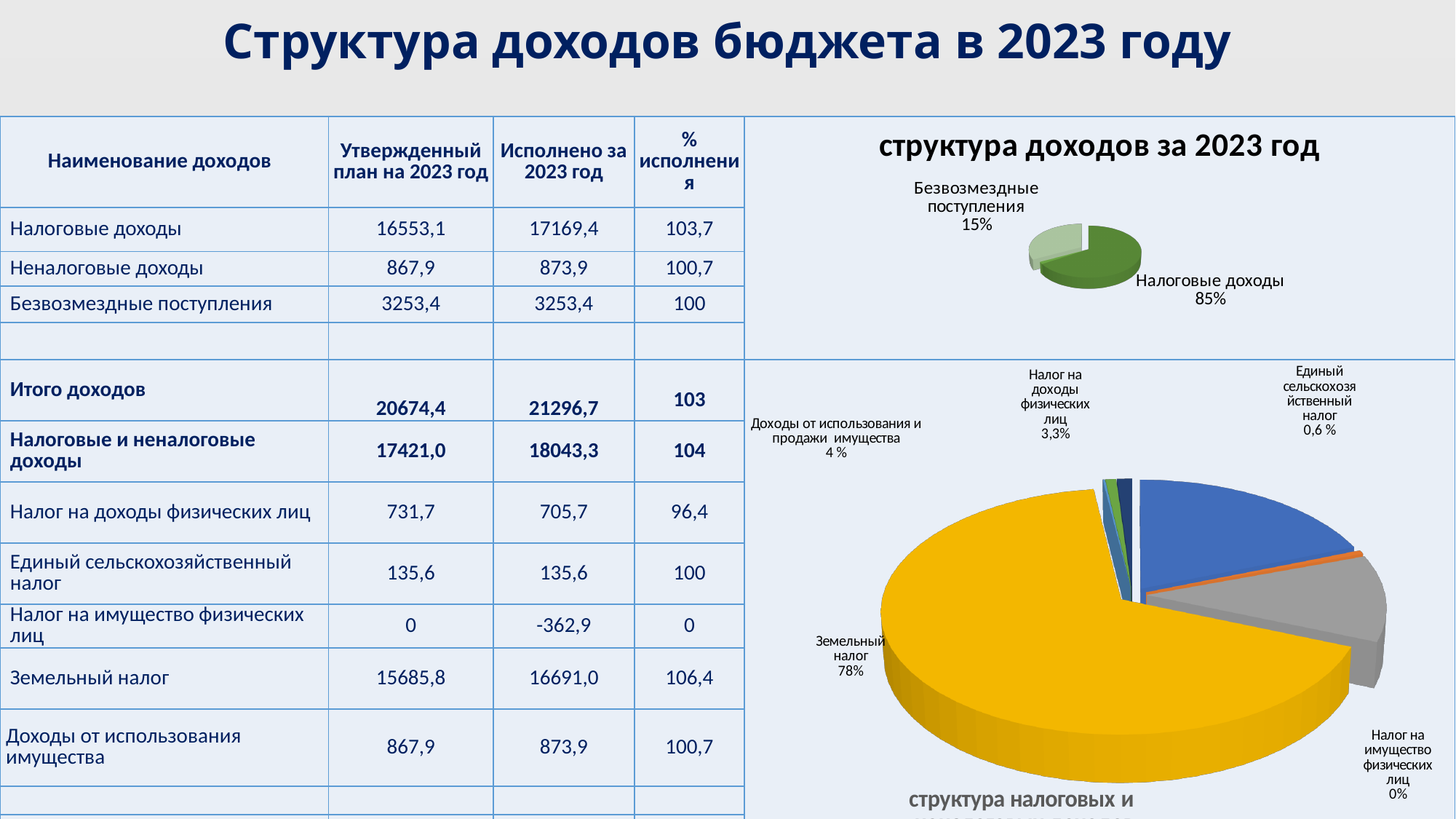
In the bottom pie chart on the slide, what share is shown for Налог на доходы физических лиц? 3,3% In the chart titled "структура доходов за 2023 год", what share is shown for Безвозмездные поступления? 15% In the bottom pie chart on the slide, what share is shown for Земельный налог? 78% In the bottom pie chart on the slide, which category has the largest share? Земельный налог In the chart titled "структура доходов за 2023 год", which category has the larger share? Налоговые доходы In the bottom pie chart on the slide, what share is shown for Доходы от использования и продажи имущества? 4 % What kind of chart is the one titled "структура доходов за 2023 год"? Pie chart In the chart titled "структура доходов за 2023 год", what share is shown for Налоговые доходы? 85% In the bottom pie chart on the slide, what share is shown for Единый сельскохозяйственный налог? 0,6 % In the bottom pie chart on the slide, which category has the smallest labelled share? Налог на имущество физических лиц In the chart titled "структура доходов за 2023 год", what is the difference in percentage points between Налоговые доходы and Безвозмездные поступления? 70 percentage points